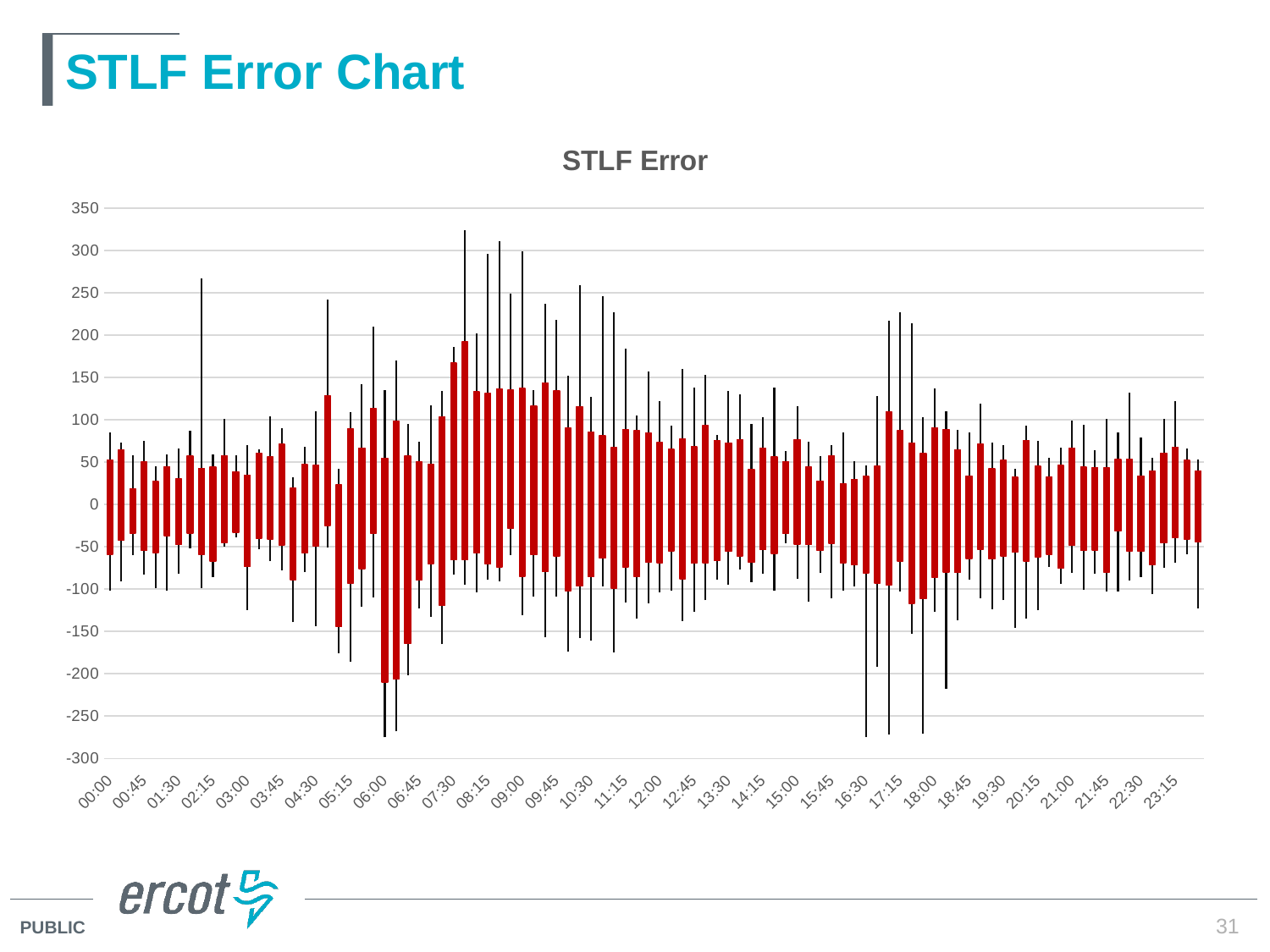
How many time labels are shown on the x axis? 32 Is the top of the tallest red bar (near 08:15) greater or less than 150? greater What is the lowest value shown on the y axis? -300 What is the title of the chart? STLF Error Is the lowest point reached by any whisker in the chart greater or less than -250? less Is the highest point reached by any whisker in the chart greater or less than 300? greater What colour are the bars in the chart? Red What is the highest value shown on the y axis? 350 What is the last time label on the x axis? 23:15 What is the interval between consecutive y-axis gridline values? 50 What is the first time label on the x axis? 00:00